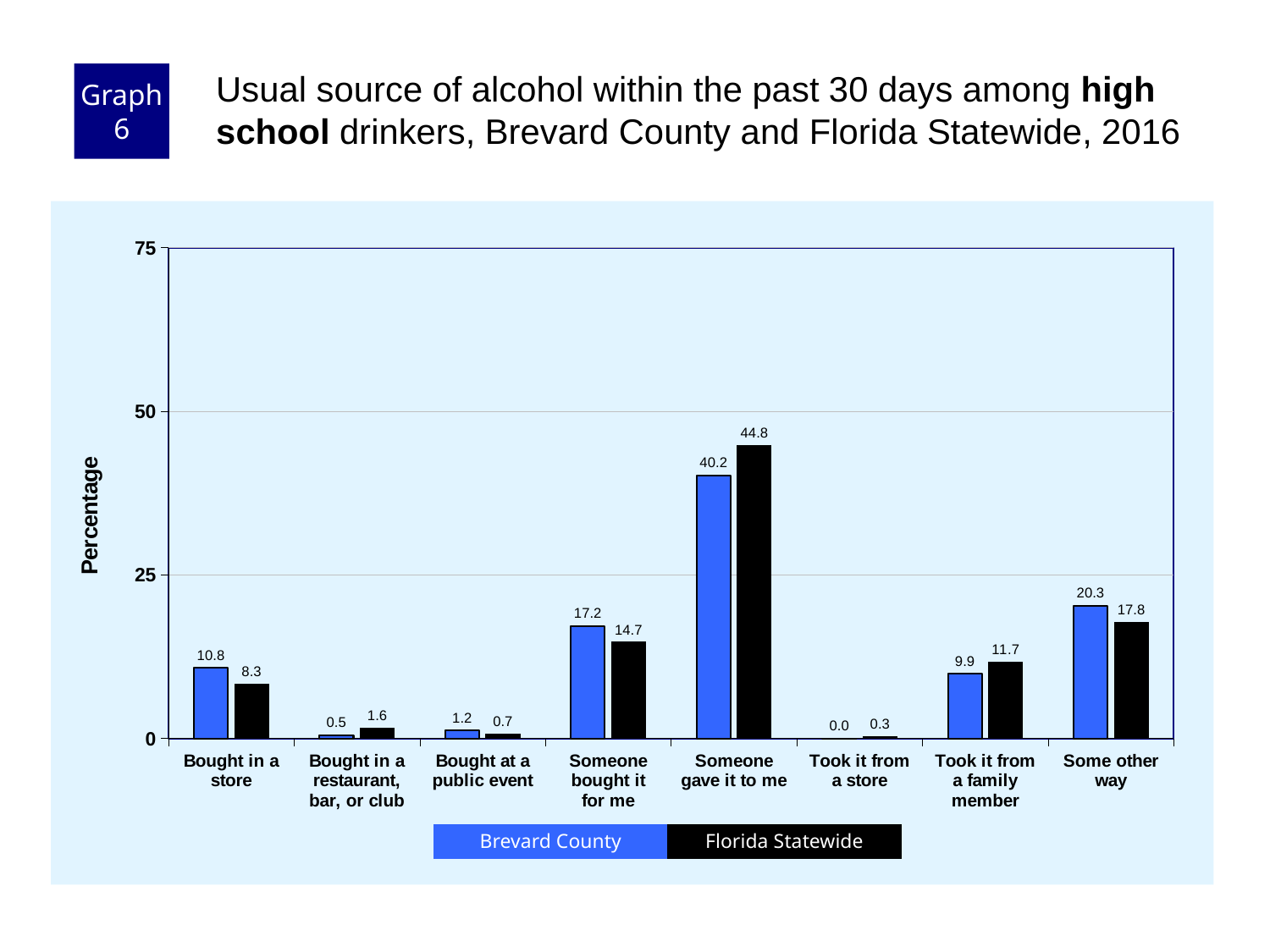
What is the difference between the Florida Statewide and Brevard County values for "Someone gave it to me"? 4.6 Is the Florida Statewide value for "Someone gave it to me" greater or less than 50? less What is the Florida Statewide value for "Took it from a family member"? 11.7 What is the Brevard County value for "Someone gave it to me"? 40.2 How many series does the legend list? 2 Which category has the lowest Brevard County value? Took it from a store Which category has the highest Florida Statewide value? Someone gave it to me How many categories are shown on the x axis? 8 For "Someone bought it for me", which is larger: Brevard County or Florida Statewide? Brevard County What is the Brevard County value for "Bought in a store"? 10.8 What is the difference between the Brevard County and Florida Statewide values for "Some other way"? 2.5 What kind of chart is shown on the slide? Bar chart